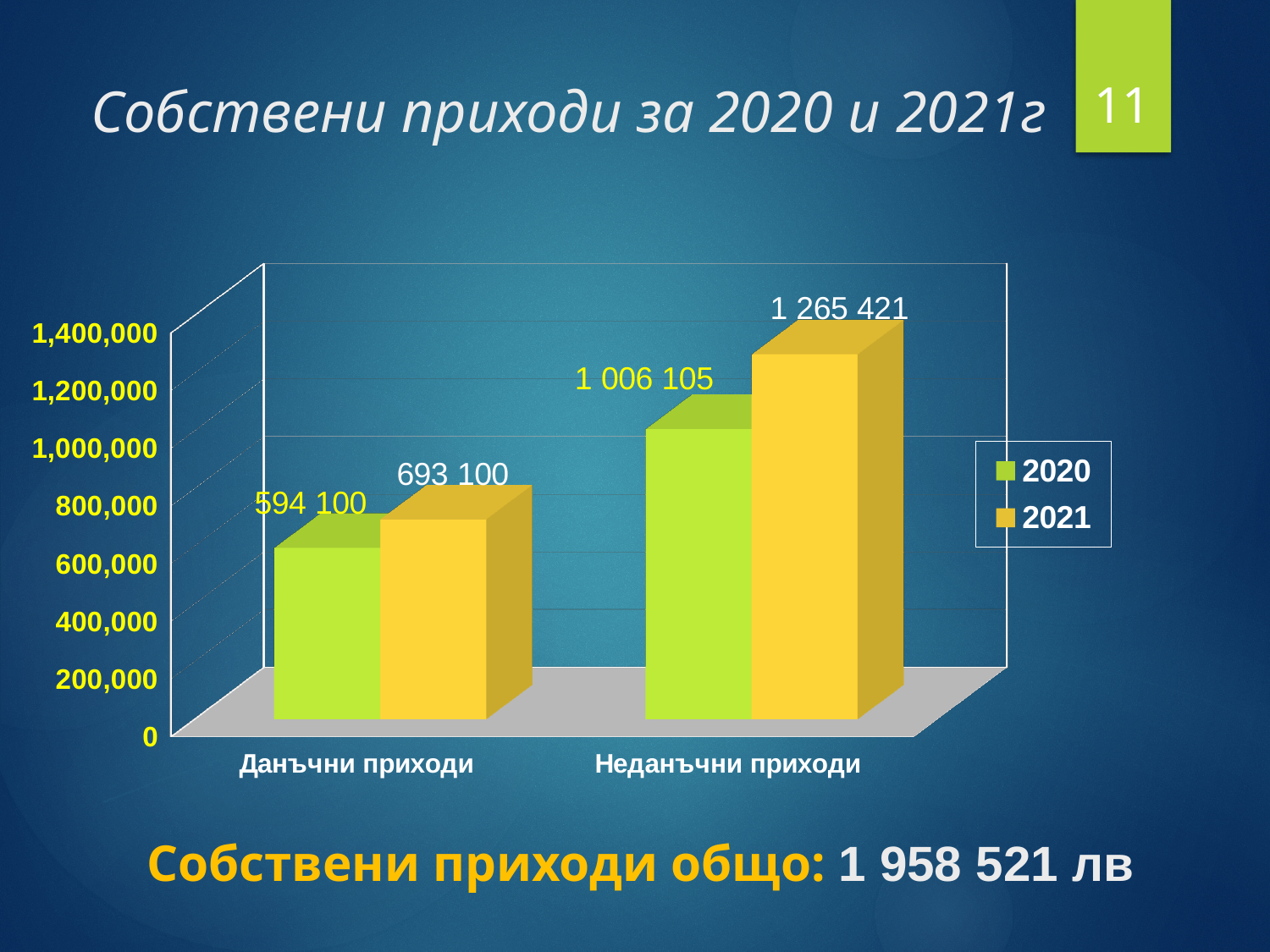
What kind of chart is shown on the slide? Bar chart What is the value for Данъчни приходи in 2020? 594 100 What is the value for Данъчни приходи in 2021? 693 100 Which is larger: Неданъчни приходи in 2020 or Данъчни приходи in 2021? Неданъчни приходи in 2020 What is the difference between the 2021 and 2020 values for Неданъчни приходи? 259 316 How many series does the legend list? 2 Which bar has the highest value on the chart? Неданъчни приходи, 2021 What is the value for Неданъчни приходи in 2020? 1 006 105 How many categories are shown on the x axis? 2 What is the value for Неданъчни приходи in 2021? 1 265 421 Which bar has the lowest value on the chart? Данъчни приходи, 2020 What is the difference between the 2021 and 2020 values for Данъчни приходи? 99 000